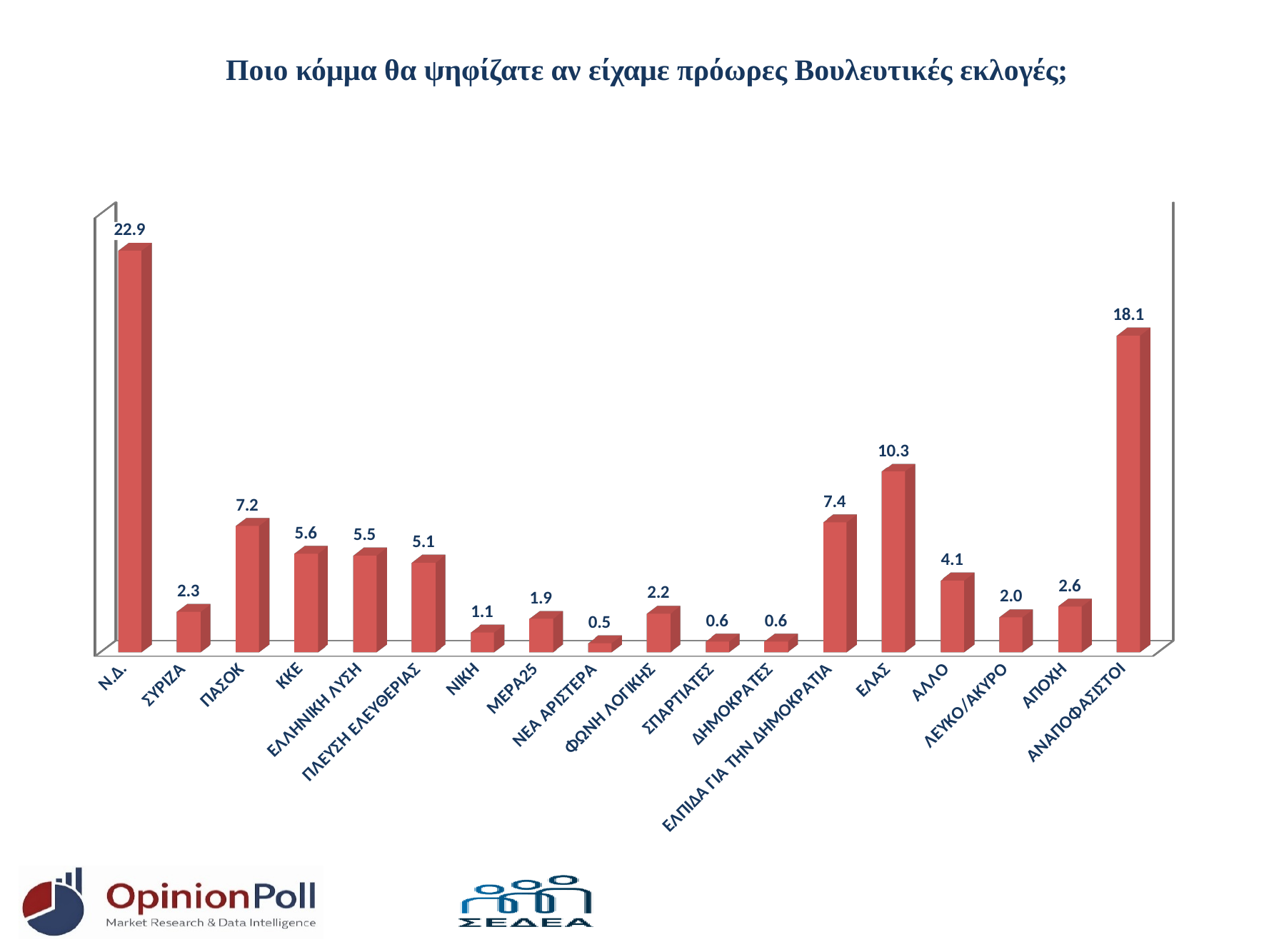
Which category has the highest value? Ν.Δ. What kind of chart is shown on the slide? Bar chart What is the value for ΕΛΑΣ? 10.3 What is the difference between the values for ΕΛΑΣ and ΕΛΠΙΔΑ ΓΙΑ ΤΗΝ ΔΗΜΟΚΡΑΤΙΑ? 2.9 What is the value for Ν.Δ.? 22.9 How many categories are shown on the x axis? 18 Which is larger, the value for ΠΑΣΟΚ or the value for ΕΛΑΣ? ΕΛΑΣ What is the title of the chart? Ποιο κόμμα θα ψηφίζατε αν είχαμε πρόωρες Βουλευτικές εκλογές; What is the value for ΠΛΕΥΣΗ ΕΛΕΥΘΕΡΙΑΣ? 5.1 Which category has the lowest value? ΝΕΑ ΑΡΙΣΤΕΡΑ What is the difference between the values for Ν.Δ. and ΑΝΑΠΟΦΑΣΙΣΤΟΙ? 4.8 What is the value for ΑΝΑΠΟΦΑΣΙΣΤΟΙ? 18.1